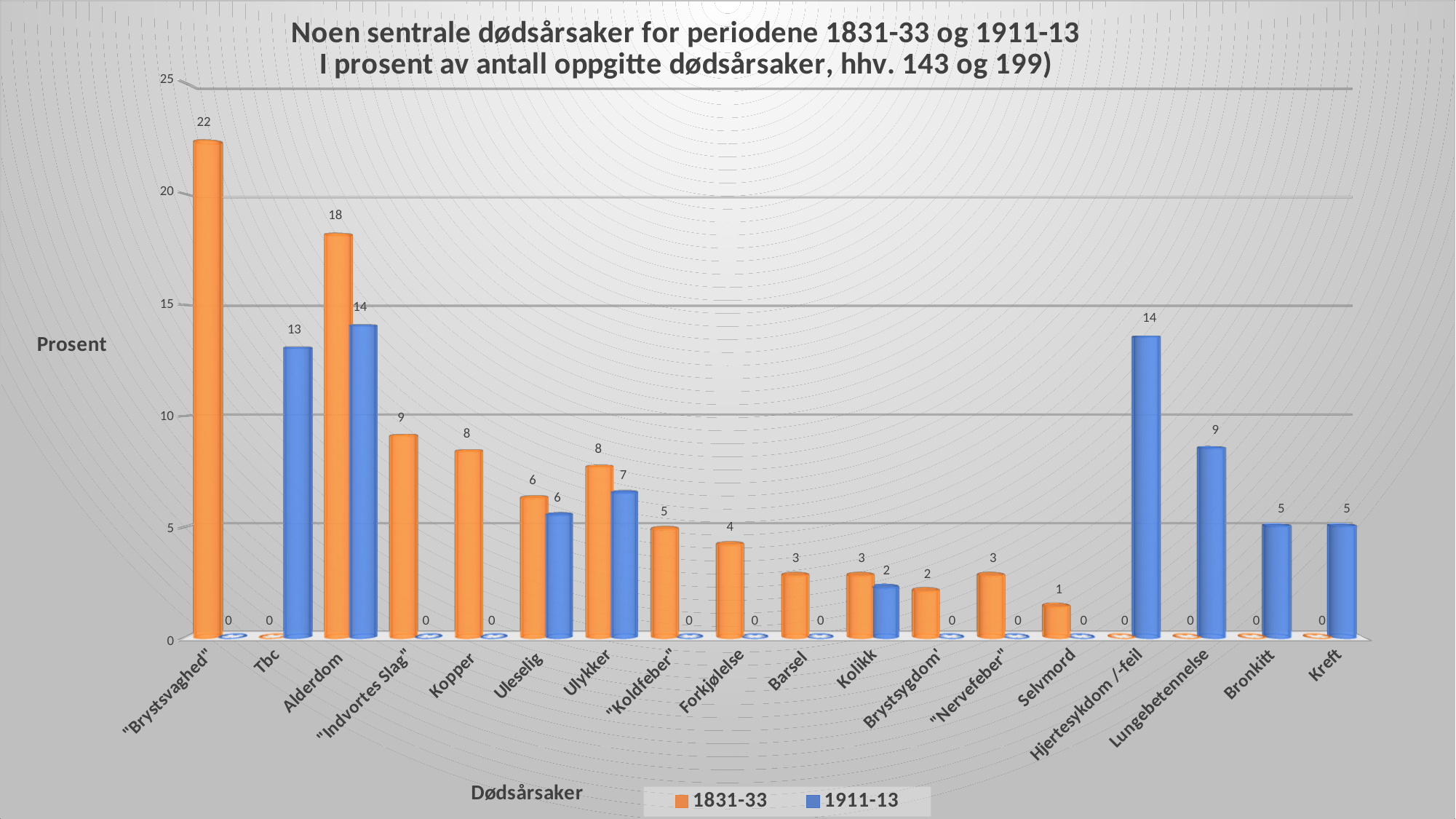
What kind of chart is shown on the slide? bar chart Which category has the highest value in the 1831-33 series? "Brystsvaghed" What is the value for Lungebetennelse in the 1911-13 series? 9 What is the difference between the 1831-33 and 1911-13 values for Alderdom? 4 Is the value for "Brystsvaghed" in the 1831-33 series greater or less than 20? greater What is the value for Tbc in the 1911-13 series? 13 Which is larger for Ulykker: the 1831-33 value or the 1911-13 value? 1831-33 What is the value for Kopper in the 1831-33 series? 8 What is the label of the y axis? Prosent What is the value for Alderdom in the 1831-33 series? 18 How many series does the legend list? 2 How many categories are shown on the x axis? 18